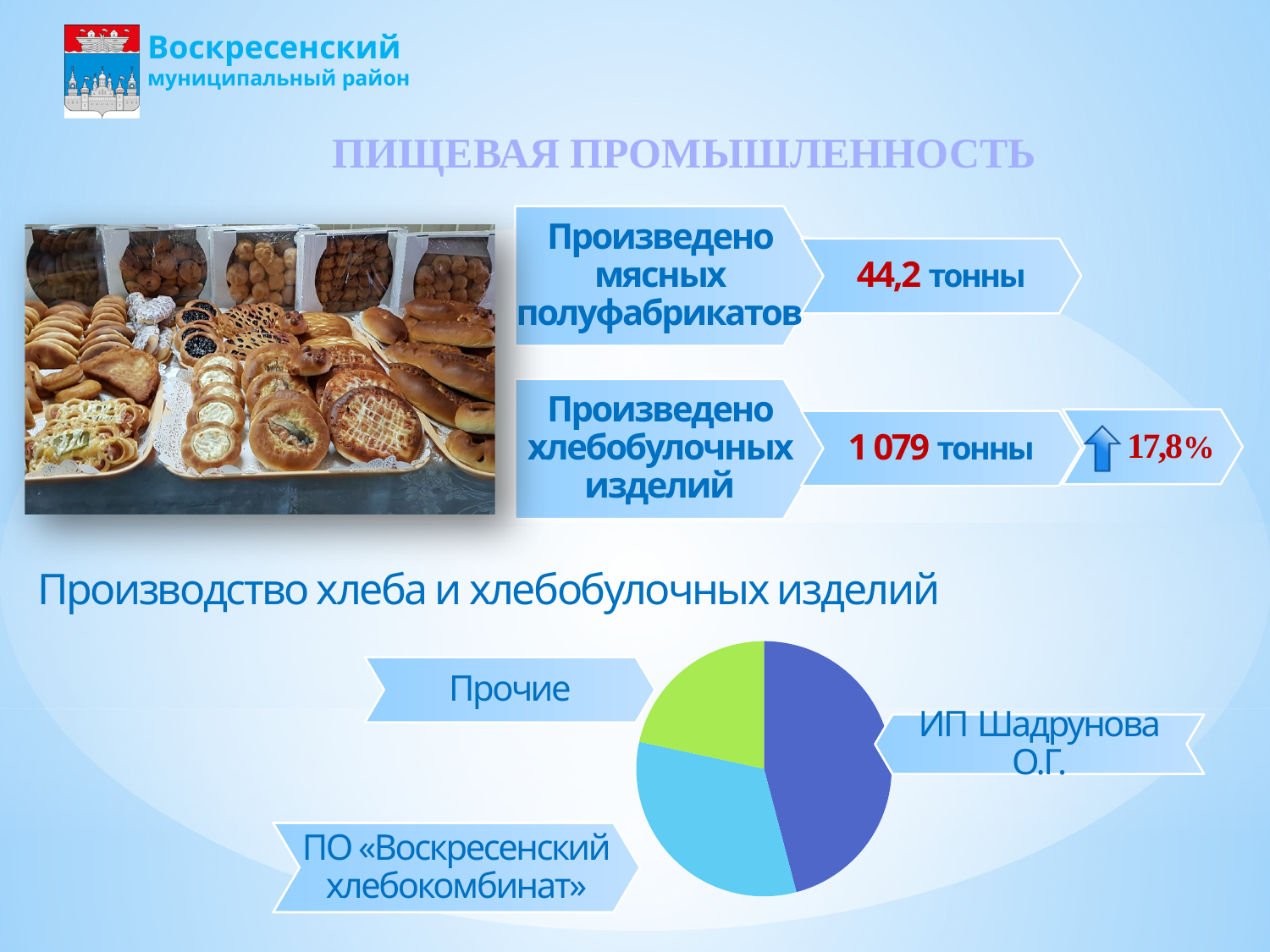
Which category has the smallest slice in the pie chart «Производство хлеба и хлебобулочных изделий»? Прочие In the pie chart «Производство хлеба и хлебобулочных изделий», which slice is larger: ИП Шадрунова О.Г. or ПО «Воскресенский хлебокомбинат»? ИП Шадрунова О.Г. What kind of chart is shown under the heading «Производство хлеба и хлебобулочных изделий»? Pie chart How many slices does the pie chart «Производство хлеба и хлебобулочных изделий» have? 3 Which category has the largest slice in the pie chart «Производство хлеба и хлебобулочных изделий»? ИП Шадрунова О.Г. In the pie chart «Производство хлеба и хлебобулочных изделий», which slice is larger: ИП Шадрунова О.Г. or Прочие? ИП Шадрунова О.Г. In the pie chart «Производство хлеба и хлебобулочных изделий», which slice is larger: ПО «Воскресенский хлебокомбинат» or Прочие? ПО «Воскресенский хлебокомбинат» What colour is the slice for Прочие in the pie chart «Производство хлеба и хлебобулочных изделий»? Green What is the title of the pie chart on the slide? Производство хлеба и хлебобулочных изделий